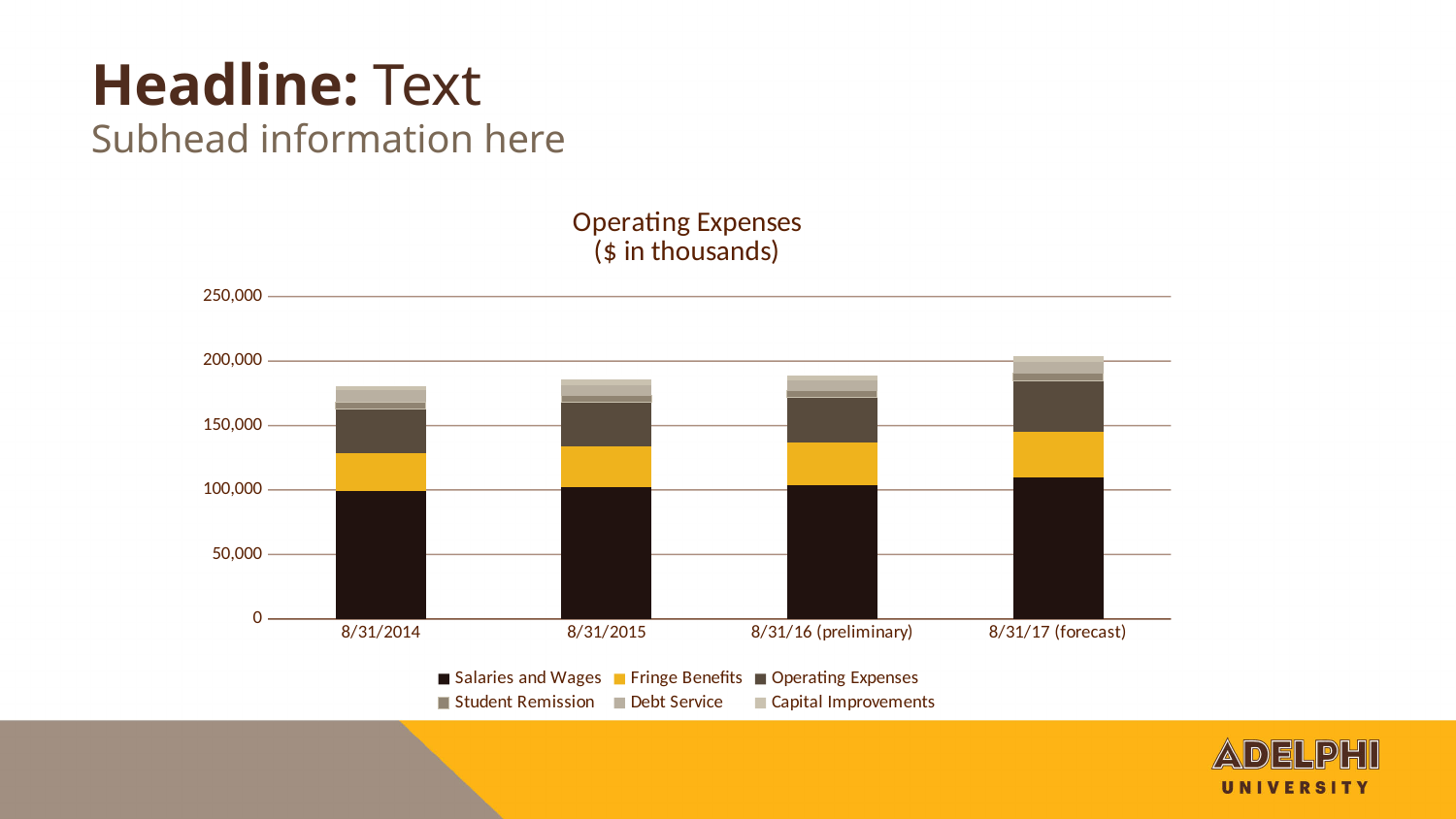
How many series does the legend list? 6 Which series is listed first in the legend? Salaries and Wages Do total operating expenses rise or fall from 8/31/2014 to 8/31/17 (forecast)? Rise What kind of chart is shown on the slide? Stacked bar chart Which category has the lowest total operating expenses? 8/31/2014 Which category has the highest total operating expenses? 8/31/17 (forecast) Is the Salaries and Wages value for 8/31/17 (forecast) greater or less than 100,000? greater What is the title of the chart? Operating Expenses ($ in thousands) Is the total for 8/31/17 (forecast) greater or less than 200,000? greater Which has the larger total, 8/31/2014 or 8/31/17 (forecast)? 8/31/17 (forecast) How many categories are shown on the x axis? 4 Is the total for 8/31/2014 greater or less than 200,000? less